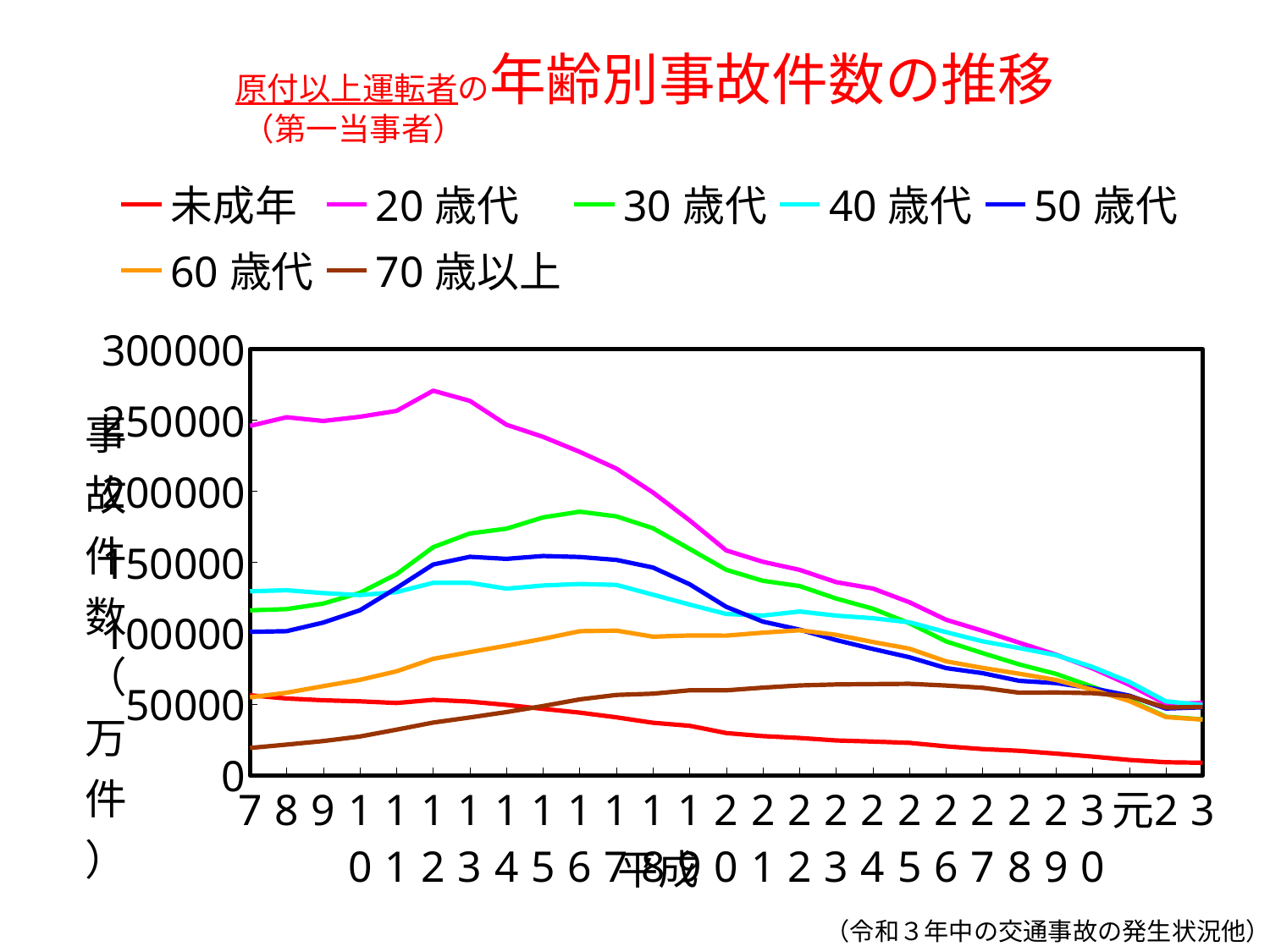
What kind of chart is shown on the slide? line chart Which series has the lowest value at 令和3, the last point on the x axis? 未成年 At 平成7, which is larger, the value for 30歳代 or the value for 50歳代? 30歳代 Is the value for 70歳以上 at 平成7 greater or less than 50000? less Is the highest value reached by the 20歳代 line greater or less than 250000? greater Is the value for 未成年 at 平成7 greater or less than 100000? less How many series does the legend list? 7 What is the source note shown at the bottom right of the slide? （令和３年中の交通事故の発生状況他） Which series has the highest value at 平成7, the first point on the x axis? 20歳代 Does the 未成年 line rise or fall overall from 平成7 to 令和3? fall Which series has the lowest value at 平成7, the first point on the x axis? 70歳以上